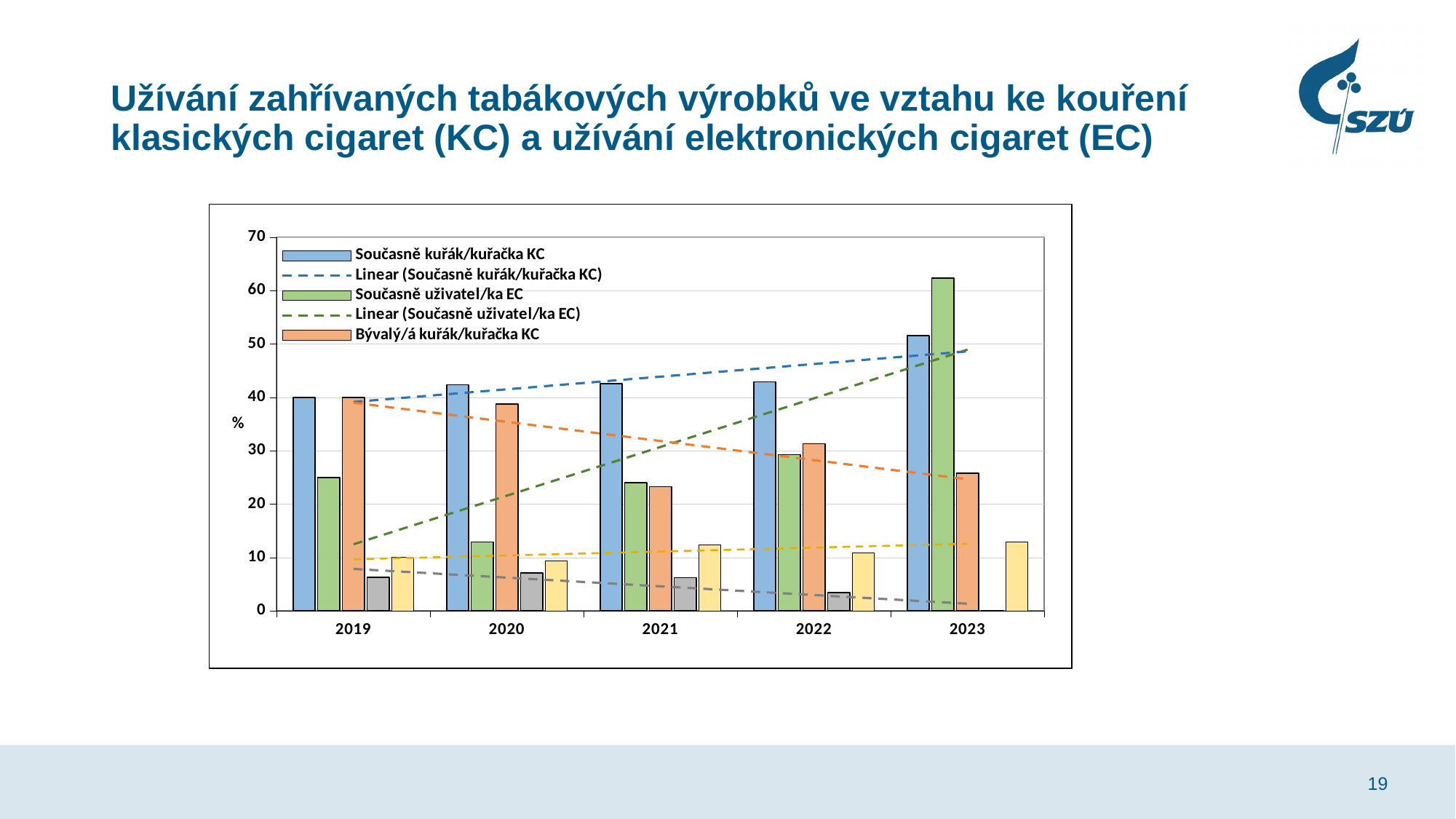
In 2023, which is larger: Současně kuřák/kuřačka KC or Současně uživatel/ka EC? Současně uživatel/ka EC How many years are shown on the x axis of the chart? 5 Is the value for Bývalý/á kuřák/kuřačka KC in 2021 greater or less than 30? less In which year is the value for Současně kuřák/kuřačka KC highest? 2023 What kind of chart is shown on the slide? Bar chart In 2020, which is larger: Současně uživatel/ka EC or Bývalý/á kuřák/kuřačka KC? Bývalý/á kuřák/kuřačka KC Does the dashed linear trend line for Současně uživatel/ka EC rise or fall from 2019 to 2023? Rise Is the value for Současně kuřák/kuřačka KC in 2023 greater or less than 50? greater Is the value for Současně uživatel/ka EC in 2023 greater or less than 60? greater How many entries does the chart's legend list? 5 In which year is the value for Současně uživatel/ka EC highest? 2023 In which year is the value for Současně uživatel/ka EC lowest? 2020